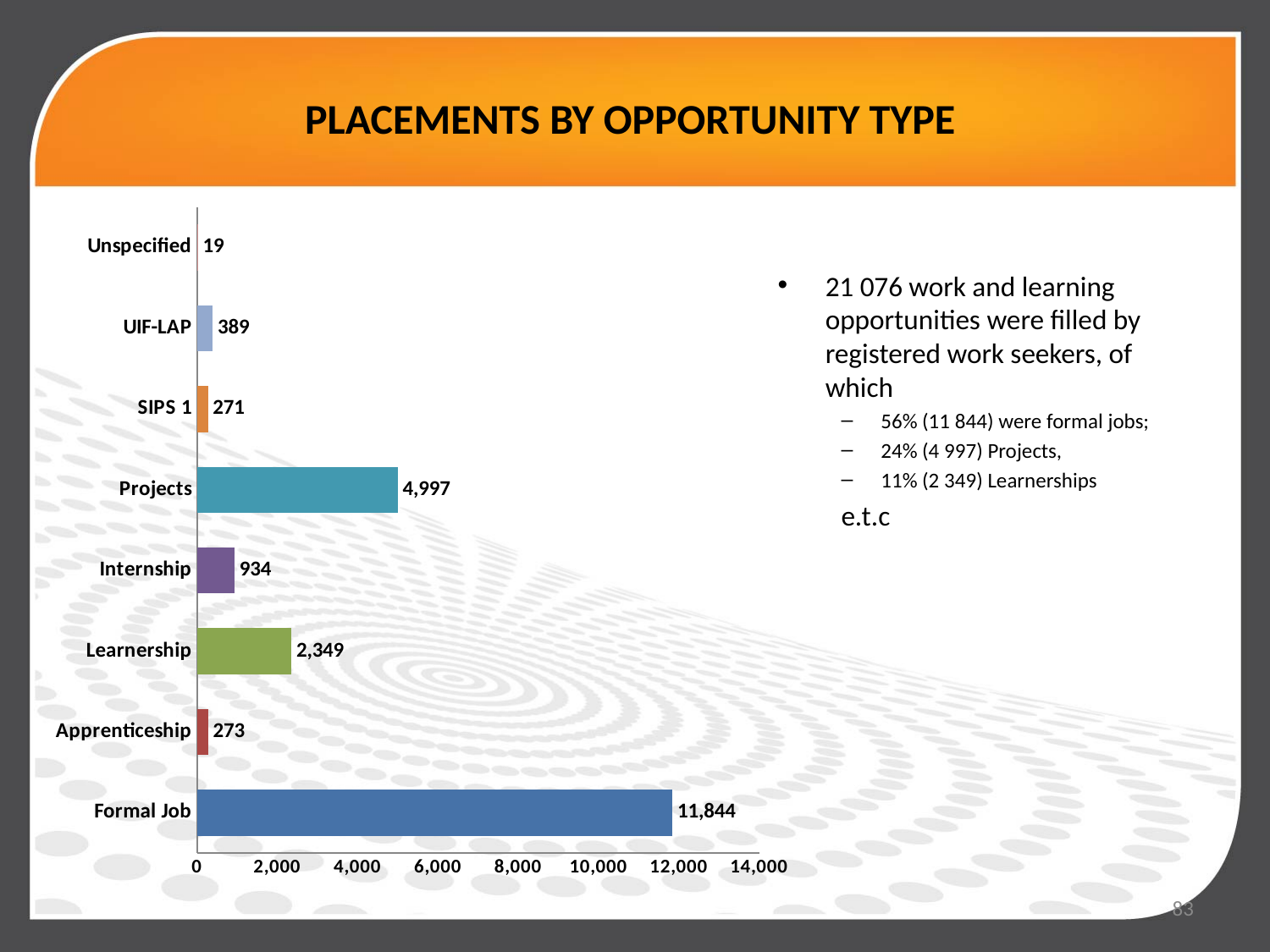
Which opportunity type has the lowest number of placements? Unspecified Which is larger, the value for Internship or the value for Apprenticeship? Internship What is the difference between the values for SIPS 1 and Apprenticeship? 2 What kind of chart is shown on the slide? Bar chart Which opportunity type has the highest number of placements? Formal Job What is the value for Formal Job? 11,844 What is the title of the slide containing the chart? PLACEMENTS BY OPPORTUNITY TYPE Is the value for Projects greater or less than 4,000? greater What is the value for UIF-LAP? 389 How many opportunity types are shown in the chart? 8 What is the value for Learnership? 2,349 What is the difference between the values for Projects and Learnership? 2,648